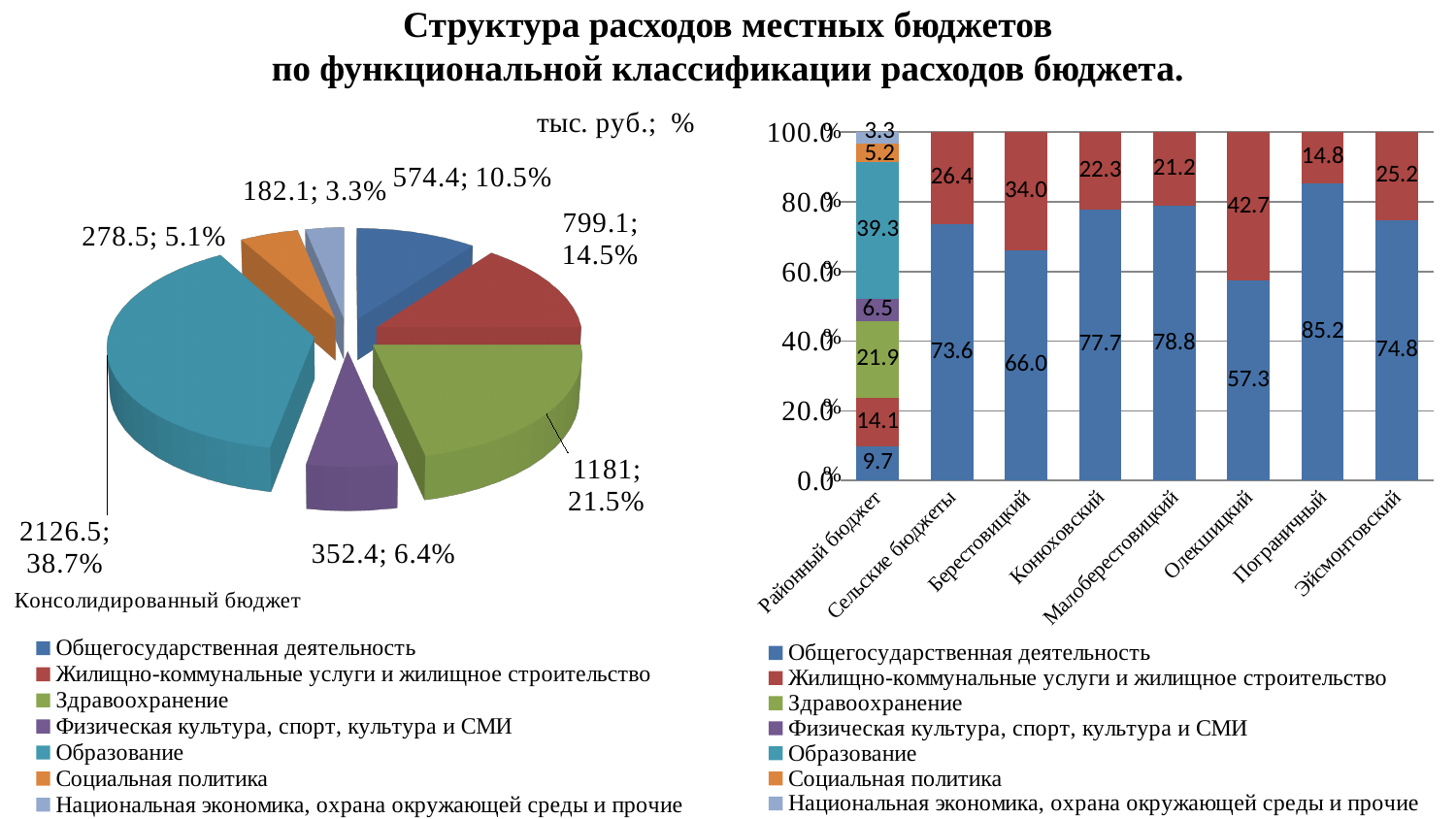
In the pie chart on the left (Консолидированный бюджет), which slice is the smallest? Национальная экономика, охрана окружающей среды и прочие In the stacked bar chart on the right, what is the difference between the Общегосударственная деятельность values for Малоберестовицкий and Берестовицкий? 12.8 In the stacked bar chart on the right, which is larger: the Жилищно-коммунальные услуги value for Берестовицкий or for Эйсмонтовский? Берестовицкий In the pie chart on the left (Консолидированный бюджет), what share does Здравоохранение have? 21.5% How many series does the legend of the stacked bar chart on the right list? 7 In the stacked bar chart on the right, what is the value of Образование for Районный бюджет? 39.3 In the pie chart on the left (Консолидированный бюджет), what value and share are shown for Образование? 2126.5; 38.7% In the stacked bar chart on the right, what is the value of Общегосударственная деятельность for Пограничный? 85.2 In the stacked bar chart on the right, which category has the lowest value for Общегосударственная деятельность? Районный бюджет How many categories are shown on the x axis of the stacked bar chart on the right? 8 In the stacked bar chart on the right, which category has the highest value for Общегосударственная деятельность? Пограничный In the stacked bar chart on the right, what is the value of Жилищно-коммунальные услуги и жилищное строительство for Олекшицкий? 42.7